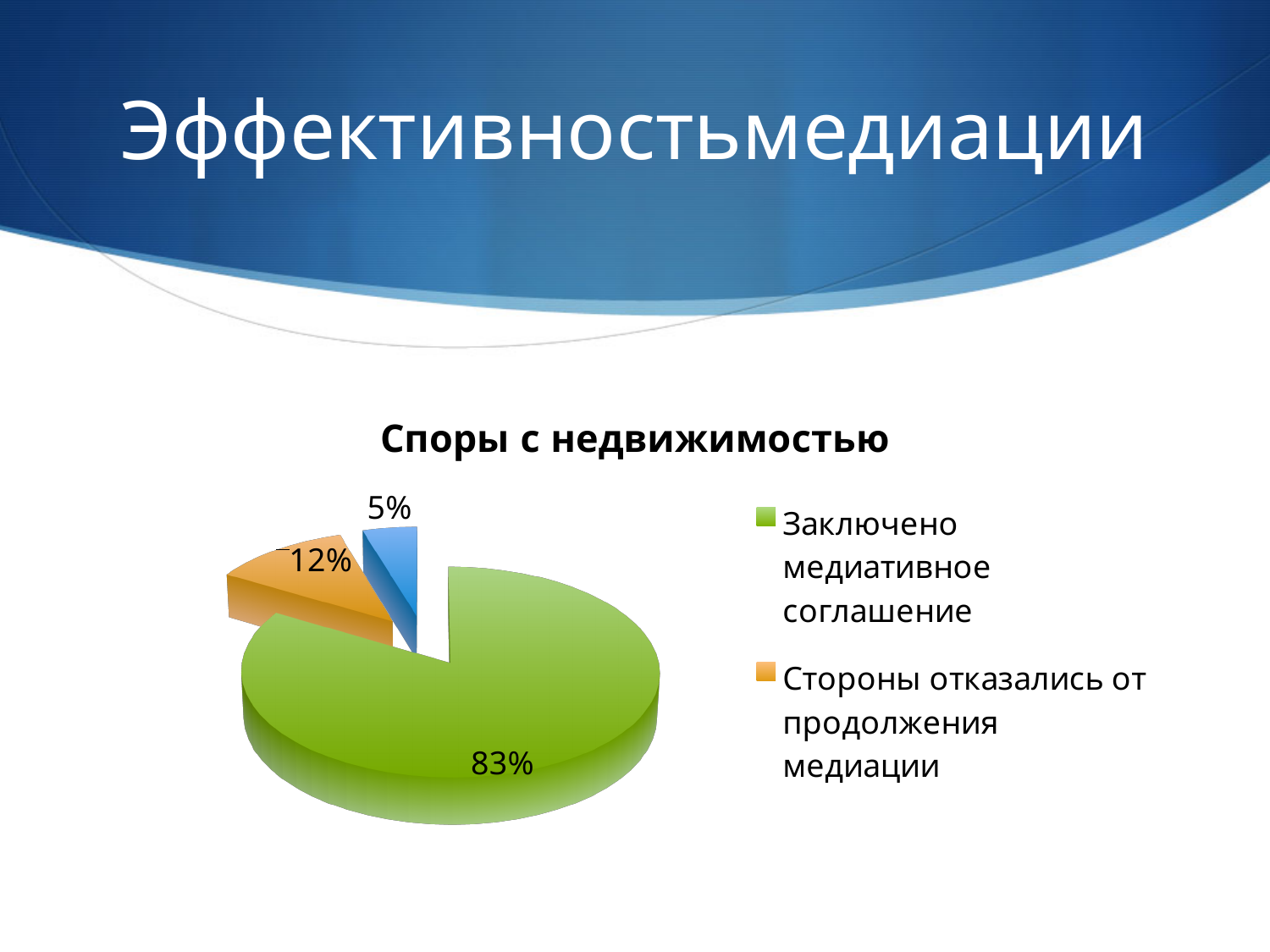
How many entries does the legend list? 2 What share of the pie is labelled "Заключено медиативное соглашение"? 83% What is the combined share of the 12% and 5% slices? 17% What is the difference between the largest slice (83%) and the slice for "Стороны отказались от продолжения медиации" (12%)? 71% How many slices does the pie chart have? 3 What is the value of the smallest slice in the pie? 5% Which category has the largest slice of the pie? Заключено медиативное соглашение What kind of chart is shown on the slide? pie chart Which is larger: the slice for "Заключено медиативное соглашение" or the slice for "Стороны отказались от продолжения медиации"? Заключено медиативное соглашение What is the title of the chart? Споры с недвижимостью What is the value for "Стороны отказались от продолжения медиации"? 12% What colour is the slice for "Заключено медиативное соглашение"? green